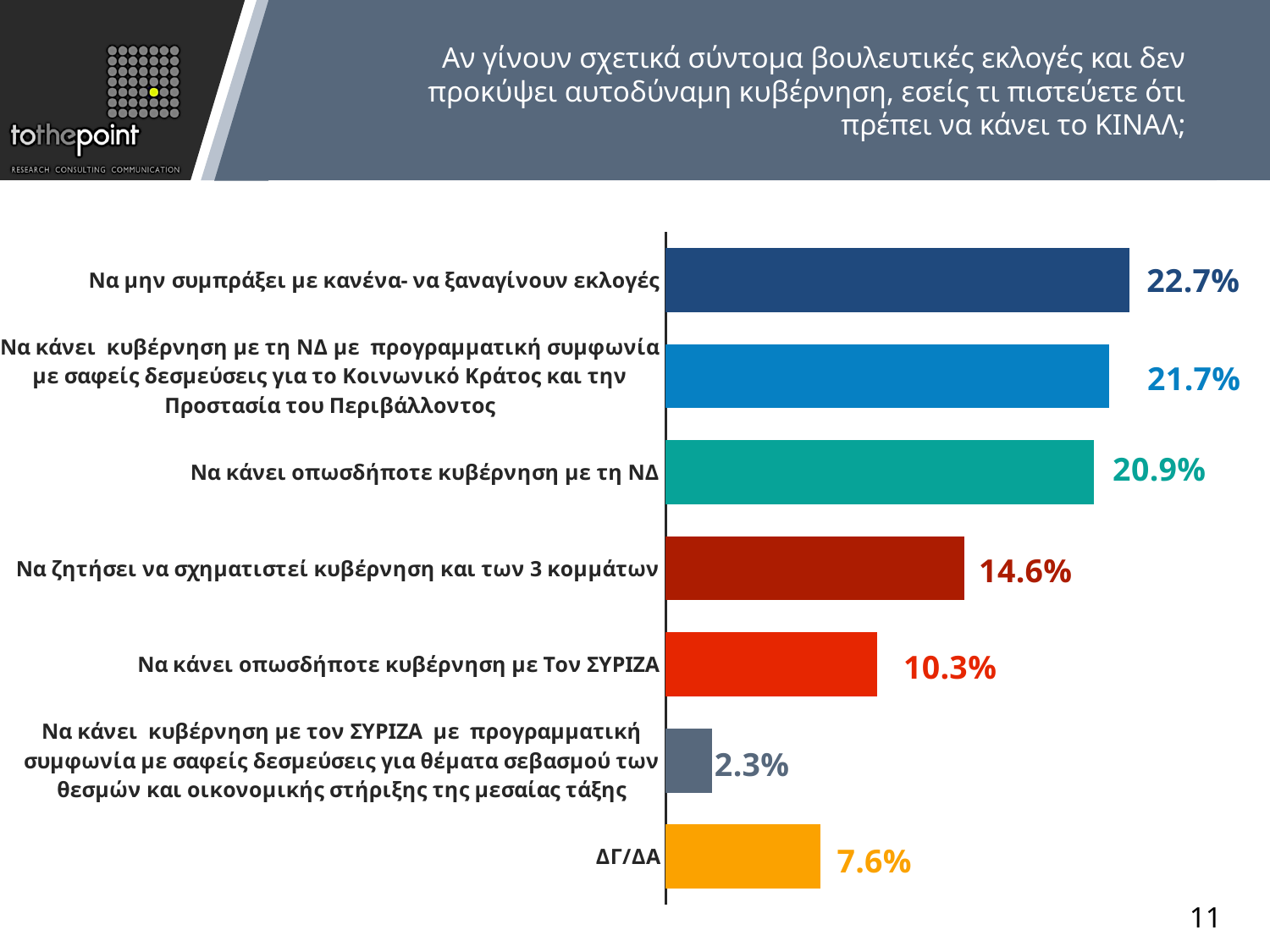
How many categories (bars) are shown in the chart? 7 What is the value for 'Να ζητήσει να σχηματιστεί κυβέρνηση και των 3 κομμάτων'? 14.6% What percentage is shown for ΔΓ/ΔΑ? 7.6% What percentage of respondents said ΚΙΝΑΛ should not cooperate with anyone and that elections should be held again (Να μην συμπράξει με κανένα- να ξαναγίνουν εκλογές)? 22.7% Which option has the highest percentage? Να μην συμπράξει με κανένα- να ξαναγίνουν εκλογές What type of chart is shown on the slide? Bar chart What is the difference between the highest value (22.7%) and the value for government with ΝΔ with a programmatic agreement (21.7%)? 1.0% Which is larger: the value for ΔΓ/ΔΑ or the value for government with ΣΥΡΙΖΑ with a programmatic agreement? ΔΓ/ΔΑ What is the value for 'Να κάνει οπωσδήποτε κυβέρνηση με τη ΝΔ'? 20.9% Which option has the lowest percentage? Να κάνει κυβέρνηση με τον ΣΥΡΙΖΑ με προγραμματική συμφωνία με σαφείς δεσμεύσεις για θέματα σεβασμού των θεσμών και οικονομικής στήριξης της μεσαίας τάξης What is the difference between 'Να ζητήσει να σχηματιστεί κυβέρνηση και των 3 κομμάτων' and 'Να κάνει οπωσδήποτε κυβέρνηση με Τον ΣΥΡΙΖΑ'? 4.3% What is the value for 'Να κάνει οπωσδήποτε κυβέρνηση με Τον ΣΥΡΙΖΑ'? 10.3%